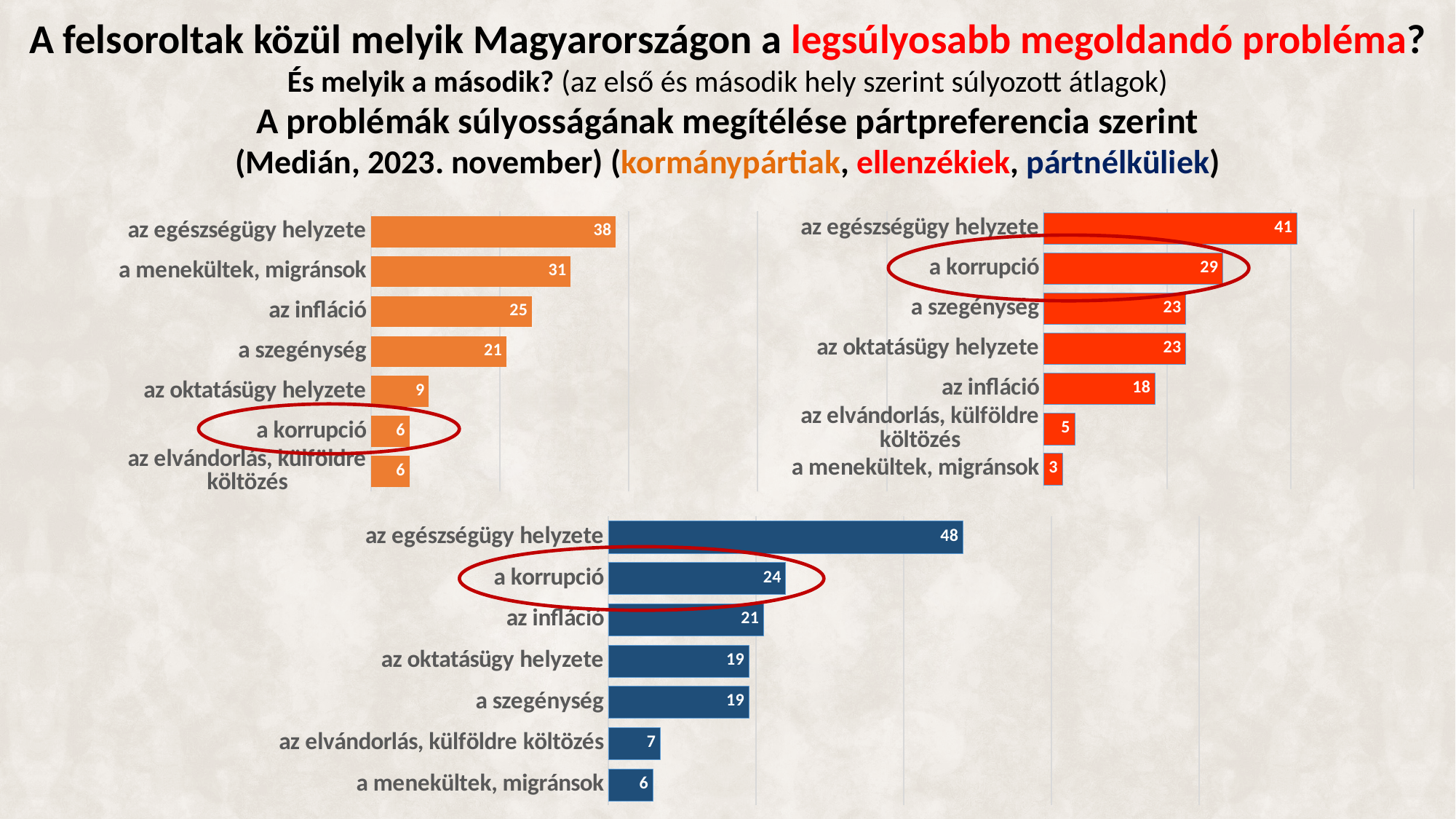
How many categories does the bottom chart show? 7 What type of chart is the top-right chart? bar chart In the top-left chart, what is the difference between 'az egészségügy helyzete' and 'a korrupció'? 32 How many charts are on the slide? 3 In the top-left chart, which is larger: 'az infláció' or 'az oktatásügy helyzete'? az infláció In the top-right chart, which is larger: 'a szegénység' or 'az infláció'? a szegénység In the bottom chart, what is the value for 'az infláció'? 21 In the top-right chart, what is the value for 'a korrupció'? 29 In the top-left chart, what is the value for 'a menekültek, migránsok'? 31 In the bottom chart, what is the difference between 'az egészségügy helyzete' and 'a korrupció'? 24 In the top-right chart, which category has the lowest value? a menekültek, migránsok In the bottom chart, which category has the highest value? az egészségügy helyzete